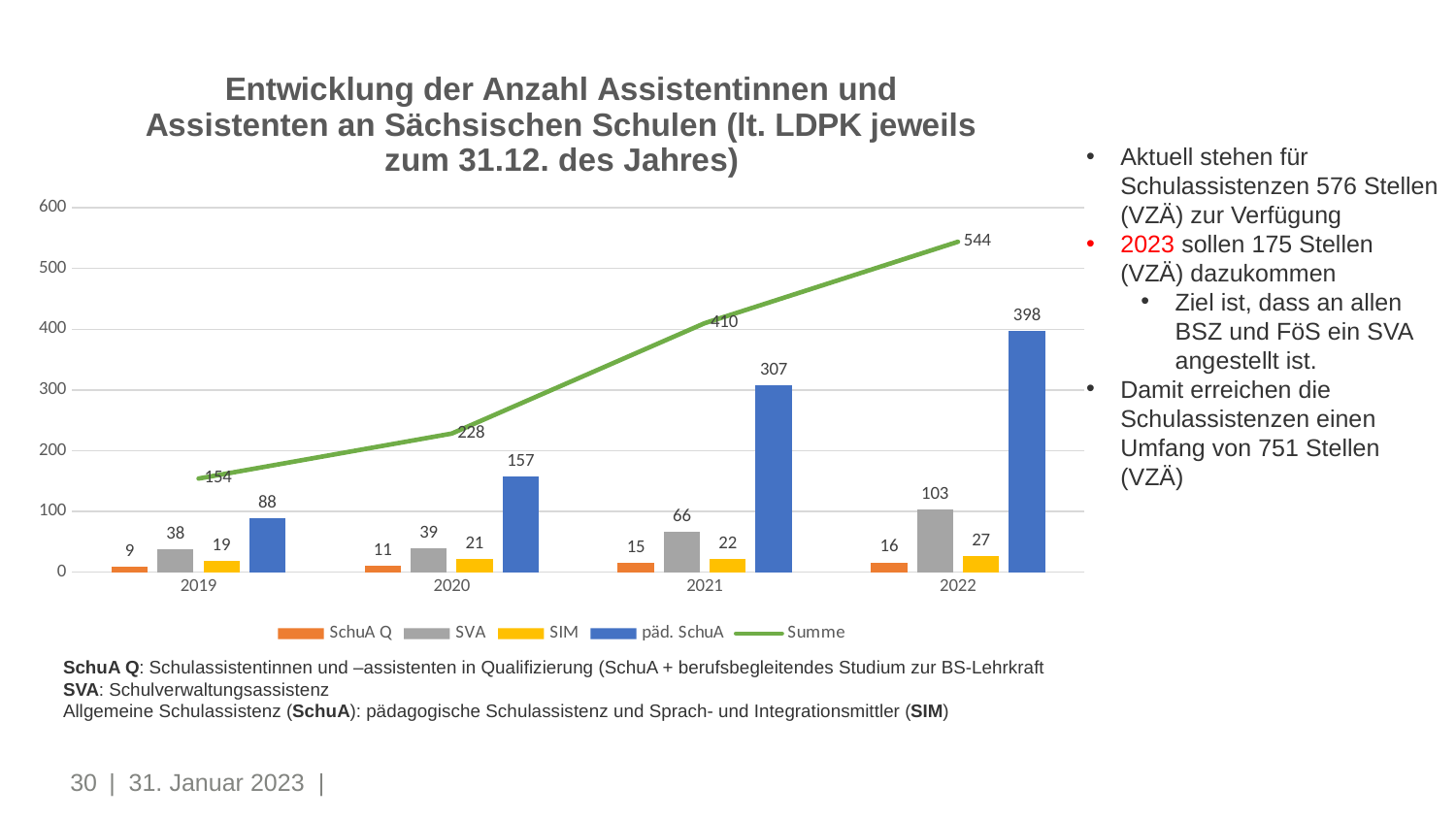
In which year is the päd. SchuA value highest? 2022 How many years are shown on the x axis? 4 What is the value of SIM in 2019? 19 What is the value of SVA in 2020? 39 How many series does the legend list? 5 What kind of chart is this? Combined bar and line chart What is the value of päd. SchuA in 2021? 307 Does the Summe line rise or fall from 2019 to 2022? Rises In which year is the SchuA Q value lowest? 2019 What is the value of the Summe line in 2022? 544 What is the difference between the SVA values in 2022 and 2021? 37 Which is larger: the päd. SchuA value in 2020 or the Summe value in 2019? päd. SchuA in 2020